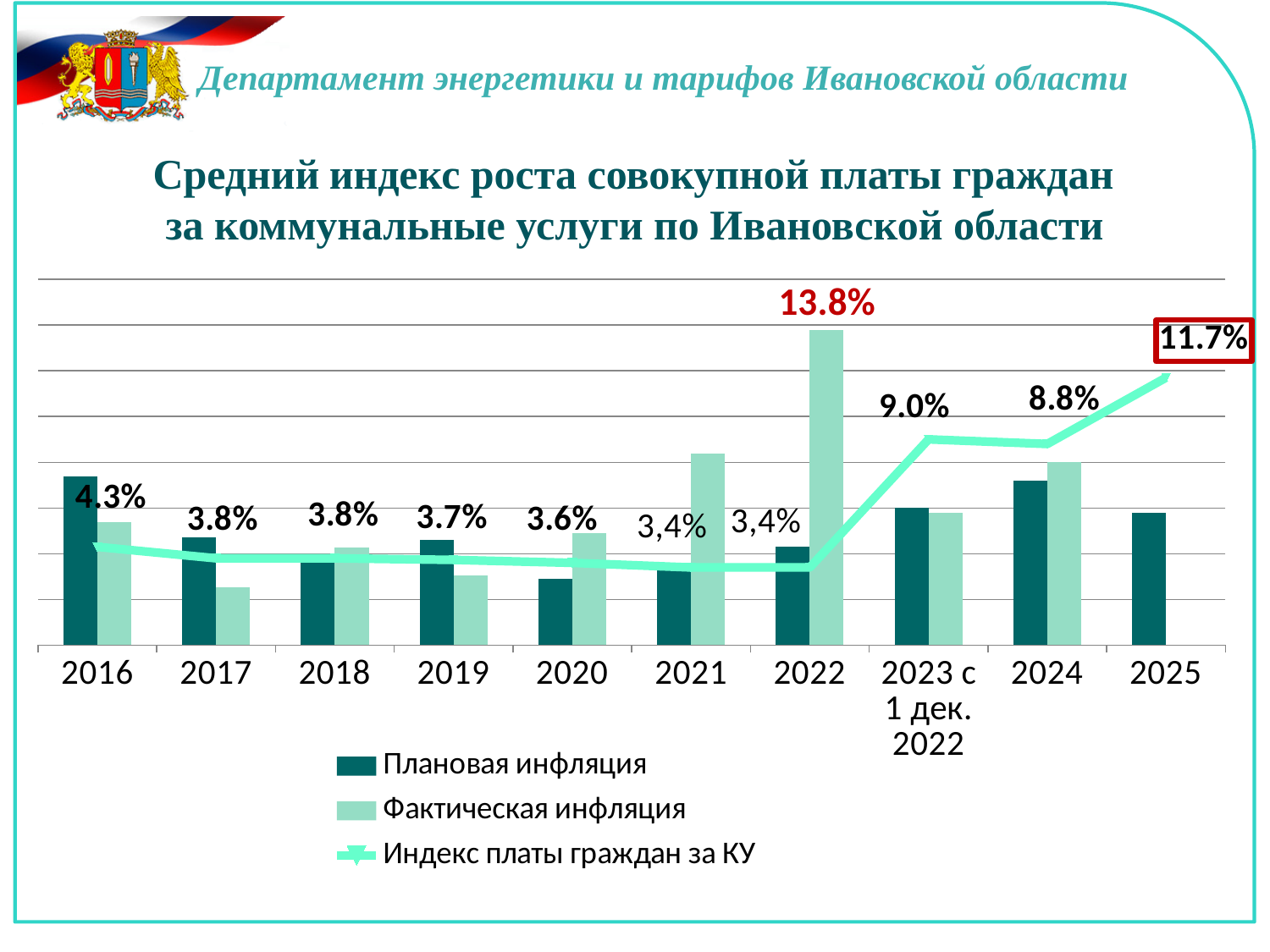
What is the value of the 'Индекс платы граждан за КУ' line for 2016? 4.3% What is the value of the 'Индекс платы граждан за КУ' line for 2024? 8.8% How many series does the legend list? 3 What is the value of the 'Индекс платы граждан за КУ' line for 2025? 11.7% What value is labelled for 'Фактическая инфляция' in 2022? 13.8% What is the value of the 'Индекс платы граждан за КУ' line for '2023 с 1 дек. 2022'? 9.0% What kind of chart is shown on the slide? Combined bar and line chart How many categories are shown on the x axis? 10 In 2021, which bar is taller: 'Плановая инфляция' or 'Фактическая инфляция'? Фактическая инфляция Does the 'Индекс платы граждан за КУ' line rise or fall from 2016 to 2020? Fall In which year does the 'Индекс платы граждан за КУ' line reach its highest value? 2025 By how many percentage points does the 'Индекс платы граждан за КУ' value for 2025 exceed the value for '2023 с 1 дек. 2022'? 2.7